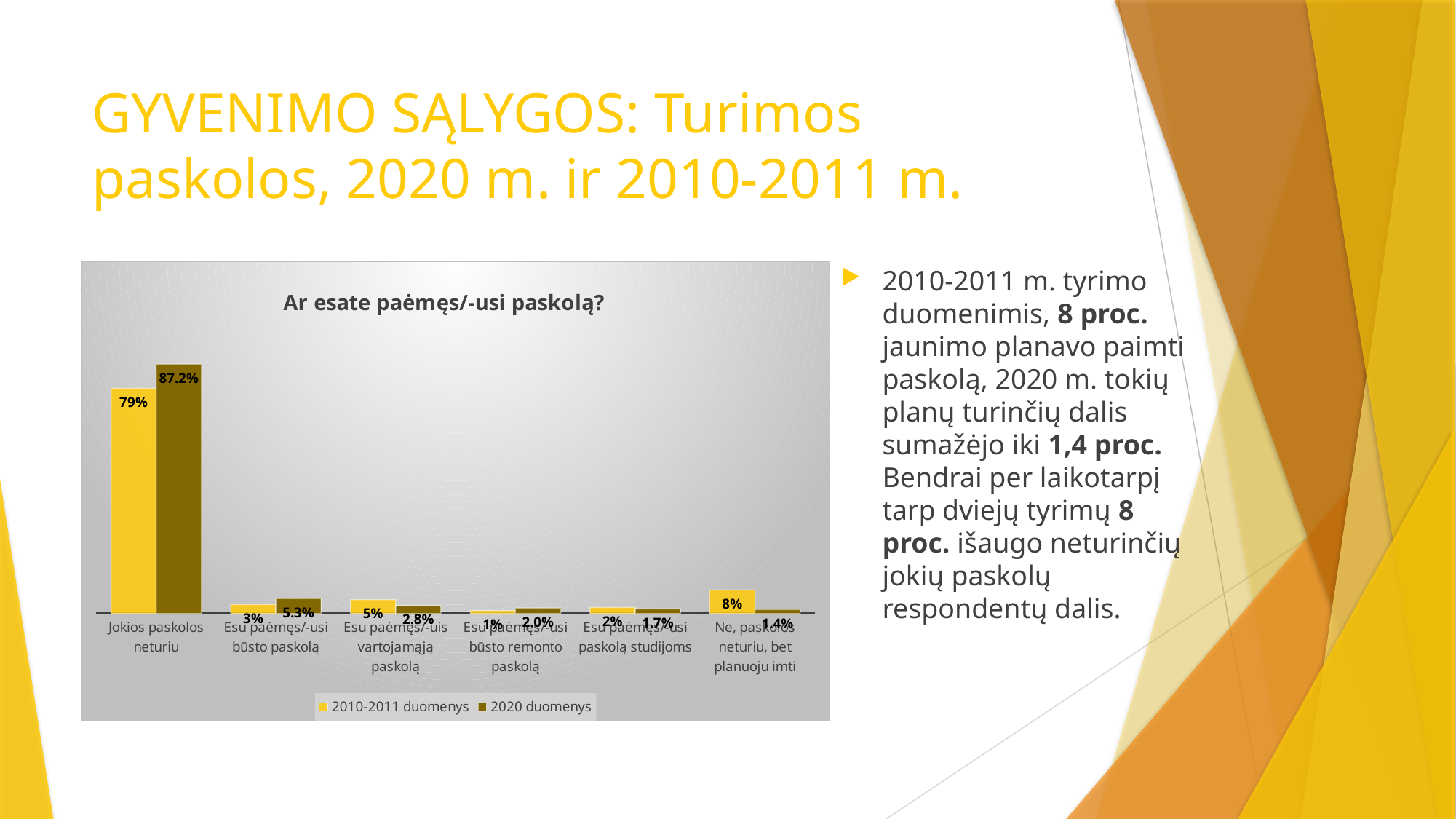
How many categories are shown on the x axis of the chart? 6 What is the difference between the 2020 duomenys and 2010-2011 duomenys values for 'Jokios paskolos neturiu'? 8.2% What type of chart is shown on the slide? bar chart Which category has the lowest value in the 2010-2011 duomenys series? Esu paėmęs/-usi būsto remonto paskolą What is the 2010-2011 duomenys value for 'Ne, paskolos neturiu, bet planuoju imti'? 8% What is the title of the chart? Ar esate paėmęs/-usi paskolą? What is the 2020 duomenys value for 'Esu paėmęs/-usi būsto paskolą'? 5.3% What is the 2010-2011 duomenys value for 'Jokios paskolos neturiu'? 79% For 'Ne, paskolos neturiu, bet planuoju imti', which series has the larger value: 2010-2011 duomenys or 2020 duomenys? 2010-2011 duomenys How many series does the chart legend list? 2 What is the 2020 duomenys value for 'Jokios paskolos neturiu'? 87.2% Which category has the highest value in the 2020 duomenys series? Jokios paskolos neturiu